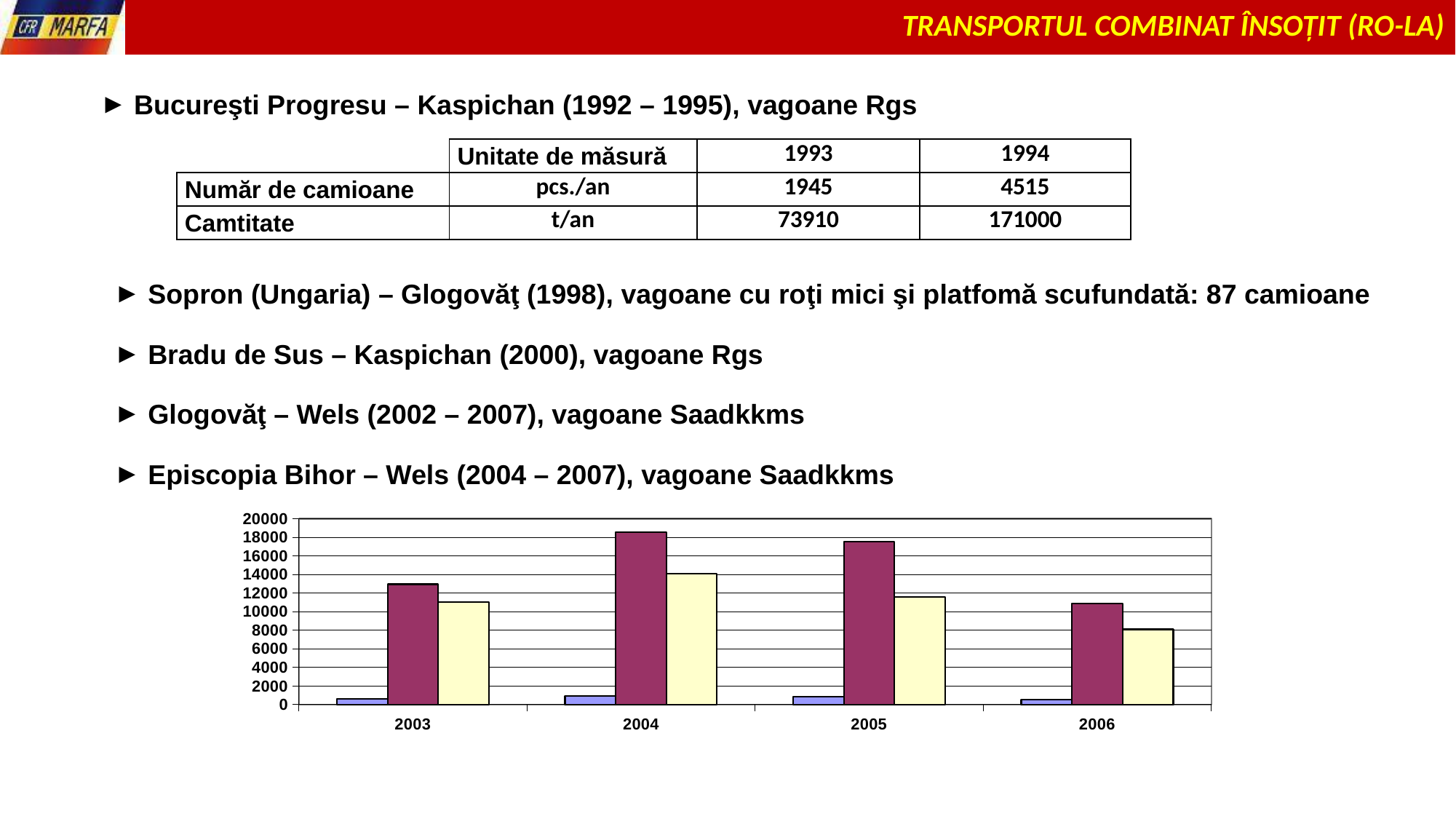
How many years are shown on the x axis of the chart? 4 Which year has the tallest purple bar in the chart? 2004 What kind of chart is shown at the bottom of the slide? bar chart For 2005, which is larger: the purple bar or the yellow bar? the purple bar Is the yellow bar for 2006 greater or less than 10000? less What is the highest value shown on the chart's vertical axis? 20000 Is the blue bar for 2004 greater or less than 2000? less Is the purple bar for 2004 greater or less than 16000? greater Which year has the shortest yellow bar in the chart? 2006 Which year has the shortest purple bar in the chart? 2006 How many bars are plotted for each year in the chart? 3